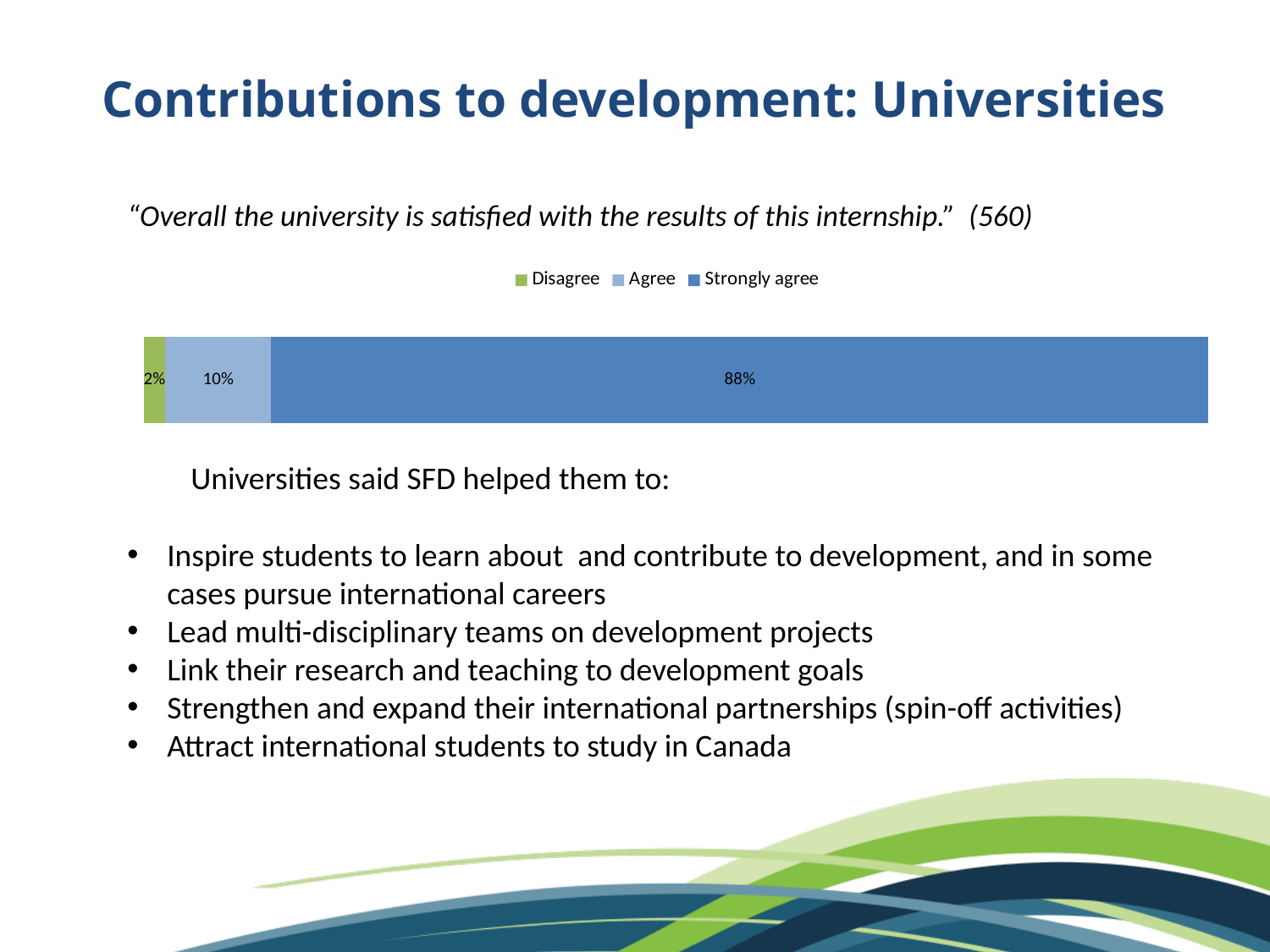
What percentage of universities disagree that they are satisfied with the results of the internship? 2% What is the difference in percentage points between Agree and Disagree? 8 What kind of chart is shown on the slide? Stacked bar chart What percentage of universities agree (but not strongly) that they are satisfied with the results of the internship? 10% How many series does the legend list? 3 What percentage of universities strongly agree that they are satisfied with the results of the internship? 88% What colour is the Strongly agree segment in the chart? Blue What is the total of the three segments in the stacked bar? 100% Which response category has the smallest share in the chart? Disagree Which is larger, the share for Agree or the share for Disagree? Agree What is the difference in percentage points between Strongly agree and Agree? 78 Which response category has the largest share in the chart? Strongly agree